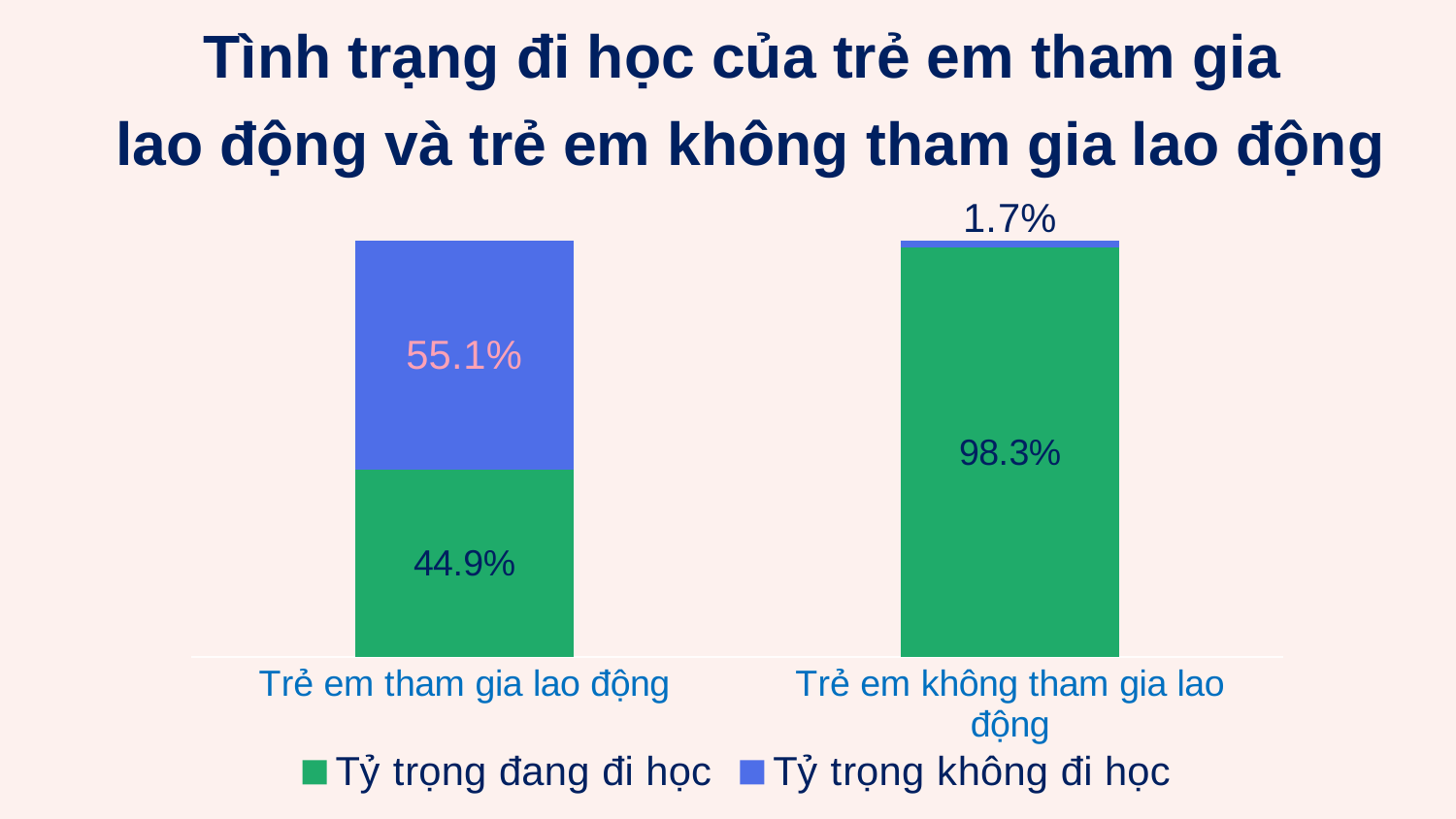
Which category has the higher value for "Tỷ trọng đang đi học"? Trẻ em không tham gia lao động How many series does the legend list? 2 What is the total of the stacked bar for "Trẻ em không tham gia lao động"? 100% What is the value of "Tỷ trọng không đi học" for "Trẻ em tham gia lao động"? 55.1% What is the difference between the "Tỷ trọng đang đi học" values for "Trẻ em không tham gia lao động" and "Trẻ em tham gia lao động"? 53.4% What is the value of "Tỷ trọng đang đi học" for "Trẻ em tham gia lao động"? 44.9% For "Trẻ em tham gia lao động", which is larger: "Tỷ trọng đang đi học" or "Tỷ trọng không đi học"? Tỷ trọng không đi học What kind of chart is shown on the slide? Stacked bar chart How many categories are shown on the x axis? 2 What is the value of "Tỷ trọng đang đi học" for "Trẻ em không tham gia lao động"? 98.3% What is the value of "Tỷ trọng không đi học" for "Trẻ em không tham gia lao động"? 1.7% Which category has the lower value for "Tỷ trọng không đi học"? Trẻ em không tham gia lao động